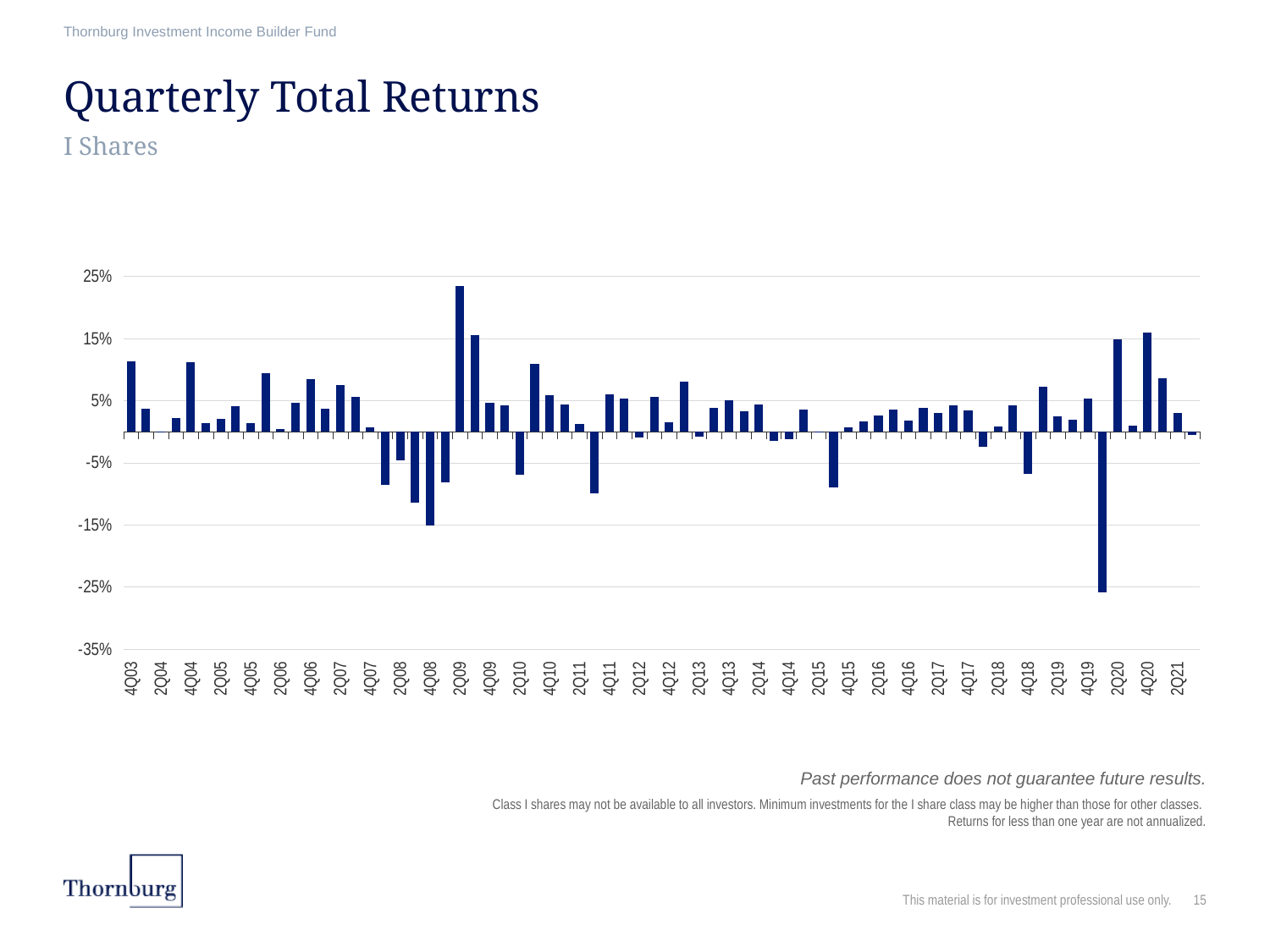
How many quarter labels are shown on the x axis? 36 What kind of chart is shown on the slide? Bar chart Which labeled quarter has the highest quarterly total return? 2Q09 Is the value for 2Q20 greater or less than 5%? greater Is the value for 4Q18 greater or less than -5%? less Which is larger, the return for 4Q20 or the return for 4Q18? 4Q20 Which is larger, the return for 2Q09 or the return for 4Q03? 2Q09 Which share class does the chart cover, according to the subtitle? I Shares Is the value for 4Q03 greater or less than 5%? greater What is the title of the chart on the slide? Quarterly Total Returns